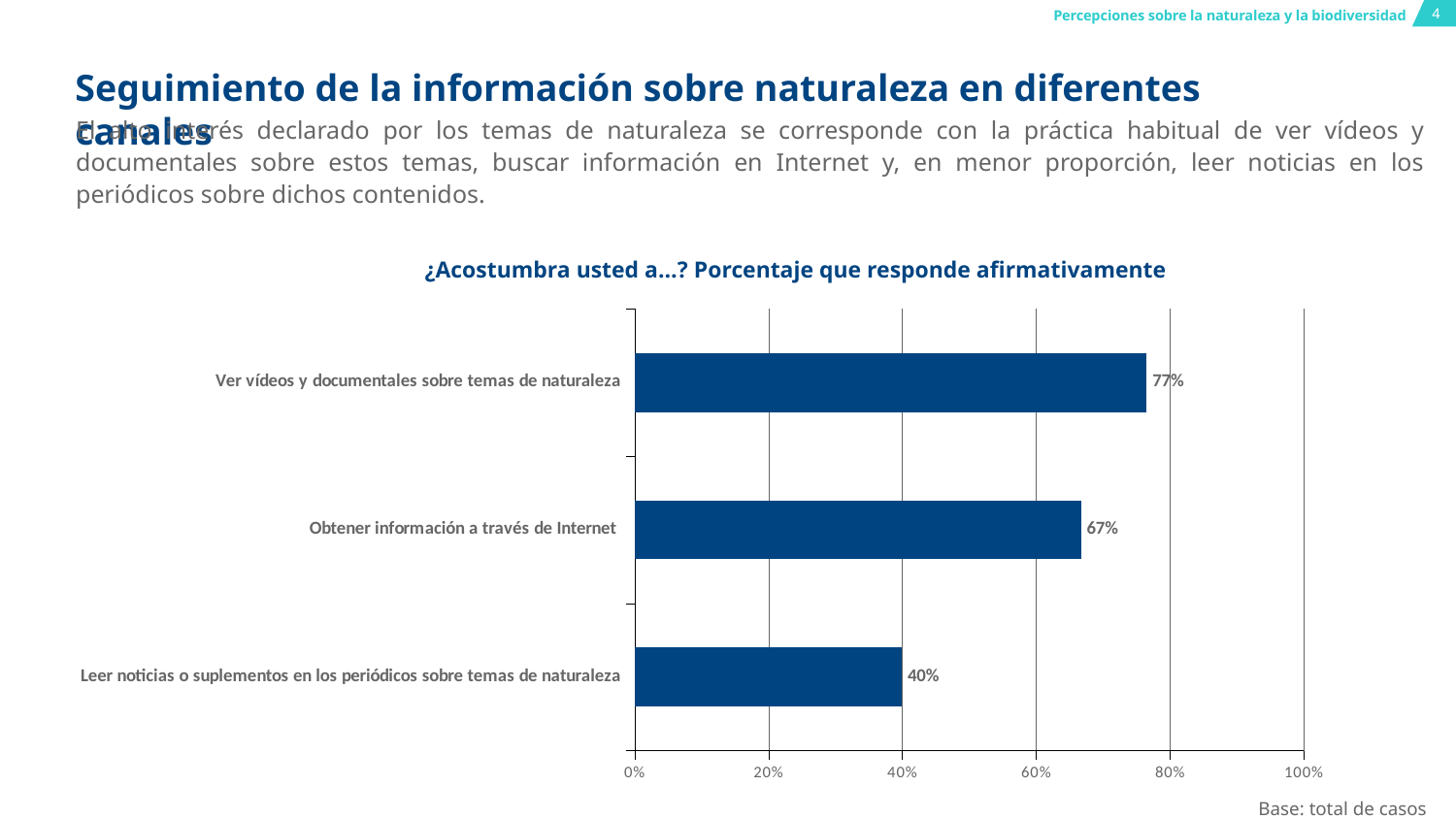
Is the value for "Obtener información a través de Internet" greater or less than 60%? greater What is the title of the chart? ¿Acostumbra usted a…? Porcentaje que responde afirmativamente What is the value for "Obtener información a través de Internet"? 67% What is the value for "Leer noticias o suplementos en los periódicos sobre temas de naturaleza"? 40% Which is larger: the value for "Obtener información a través de Internet" or for "Leer noticias o suplementos en los periódicos sobre temas de naturaleza"? Obtener información a través de Internet What is the difference between the values for "Obtener información a través de Internet" and "Leer noticias o suplementos en los periódicos sobre temas de naturaleza"? 27% What kind of chart is shown on the slide? Bar chart How many categories are shown in the chart? 3 Which category has the highest value? Ver vídeos y documentales sobre temas de naturaleza Which category has the lowest value? Leer noticias o suplementos en los periódicos sobre temas de naturaleza What is the difference between the values for "Ver vídeos y documentales sobre temas de naturaleza" and "Obtener información a través de Internet"? 10% What is the value for "Ver vídeos y documentales sobre temas de naturaleza"? 77%